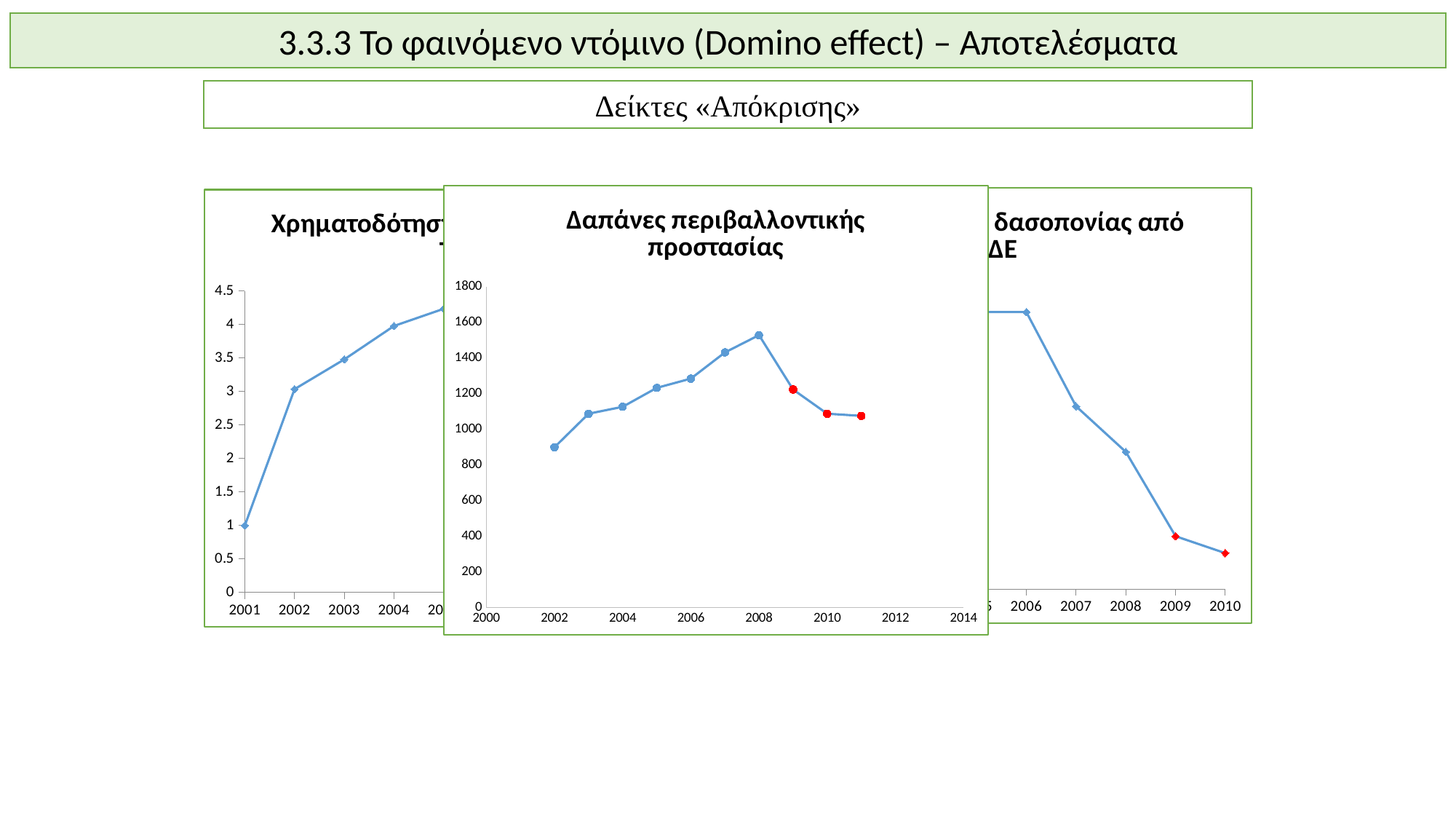
In the 'Δαπάνες περιβαλλοντικής προστασίας' chart, which year has the lowest value? 2002 In the right chart, do the values rise or fall from 2006 to 2010? fall In the 'Δαπάνες περιβαλλοντικής προστασίας' chart, how many data points are plotted? 10 In the 'Δαπάνες περιβαλλοντικής προστασίας' chart, which is larger, the value for 2007 or the value for 2010? 2007 In the left chart, do the values rise or fall from 2001 to 2004? rise In the 'Δαπάνες περιβαλλοντικής προστασίας' chart, is the value for 2008 greater or less than 1400? greater In the 'Δαπάνες περιβαλλοντικής προστασίας' chart, which year has the highest value? 2008 In the 'Δαπάνες περιβαλλοντικής προστασίας' chart, is the value for 2006 greater or less than 1400? less In the 'Δαπάνες περιβαλλοντικής προστασίας' chart, is the value for 2002 greater or less than 1000? less In the 'Δαπάνες περιβαλλοντικής προστασίας' chart, how many data points are marked in red? 3 What kind of chart is the 'Δαπάνες περιβαλλοντικής προστασίας' chart? line chart